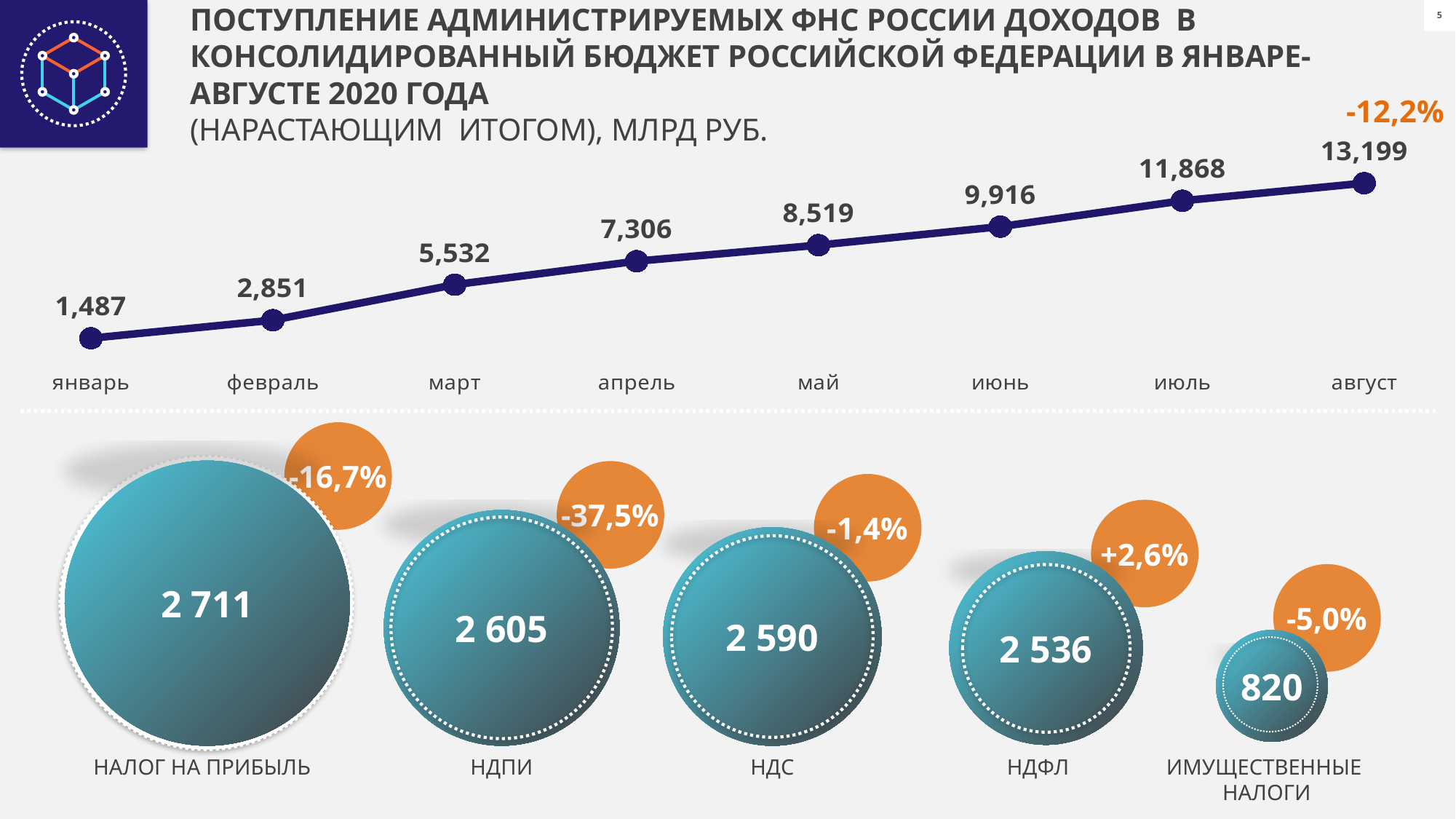
On the line chart, what is the difference between the values for август and июль? 1,331 On the line chart, what is the value for июль? 11,868 On the line chart, which month has the lowest value? январь On the line chart, do the values rise or fall from январь to август? rise On the line chart, which month has the highest value? август How many months are plotted on the line chart? 8 What kind of chart is the top chart on the slide? line chart In the bubble chart at the bottom of the slide, what is the value shown for НДС? 2 590 On the line chart, which is larger: the value for май or the value for апрель? май In the bubble chart at the bottom of the slide, what percentage change is shown for НДПИ? -37,5% On the line chart, what is the value for март? 5,532 On the line chart, what is the difference between the values for март and февраль? 2,681